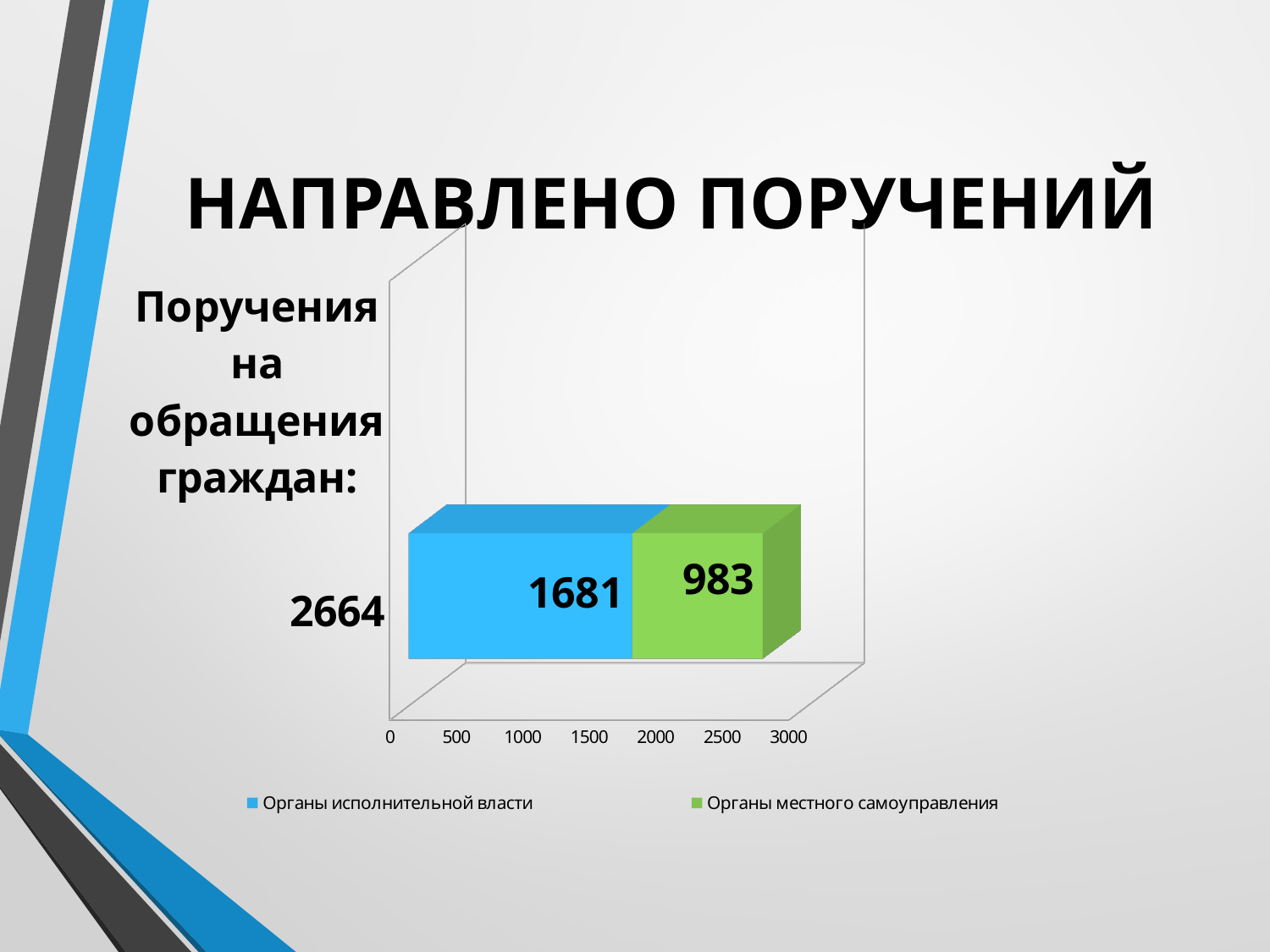
How many series does the legend list? 2 What is the title of the slide containing the chart? НАПРАВЛЕНО ПОРУЧЕНИЙ Is the value for Органы местного самоуправления greater or less than 1000? less What is the value for Органы исполнительной власти? 1681 What is the total of the stacked bar for Поручения на обращения граждан? 2664 Which series has the larger value, Органы исполнительной власти or Органы местного самоуправления? Органы исполнительной власти What is the difference between the values for Органы исполнительной власти and Органы местного самоуправления? 698 Is the value for Органы исполнительной власти greater or less than 1500? greater Which colour represents Органы местного самоуправления in the chart? green What type of chart is shown on the slide? bar chart What is the value for Органы местного самоуправления? 983